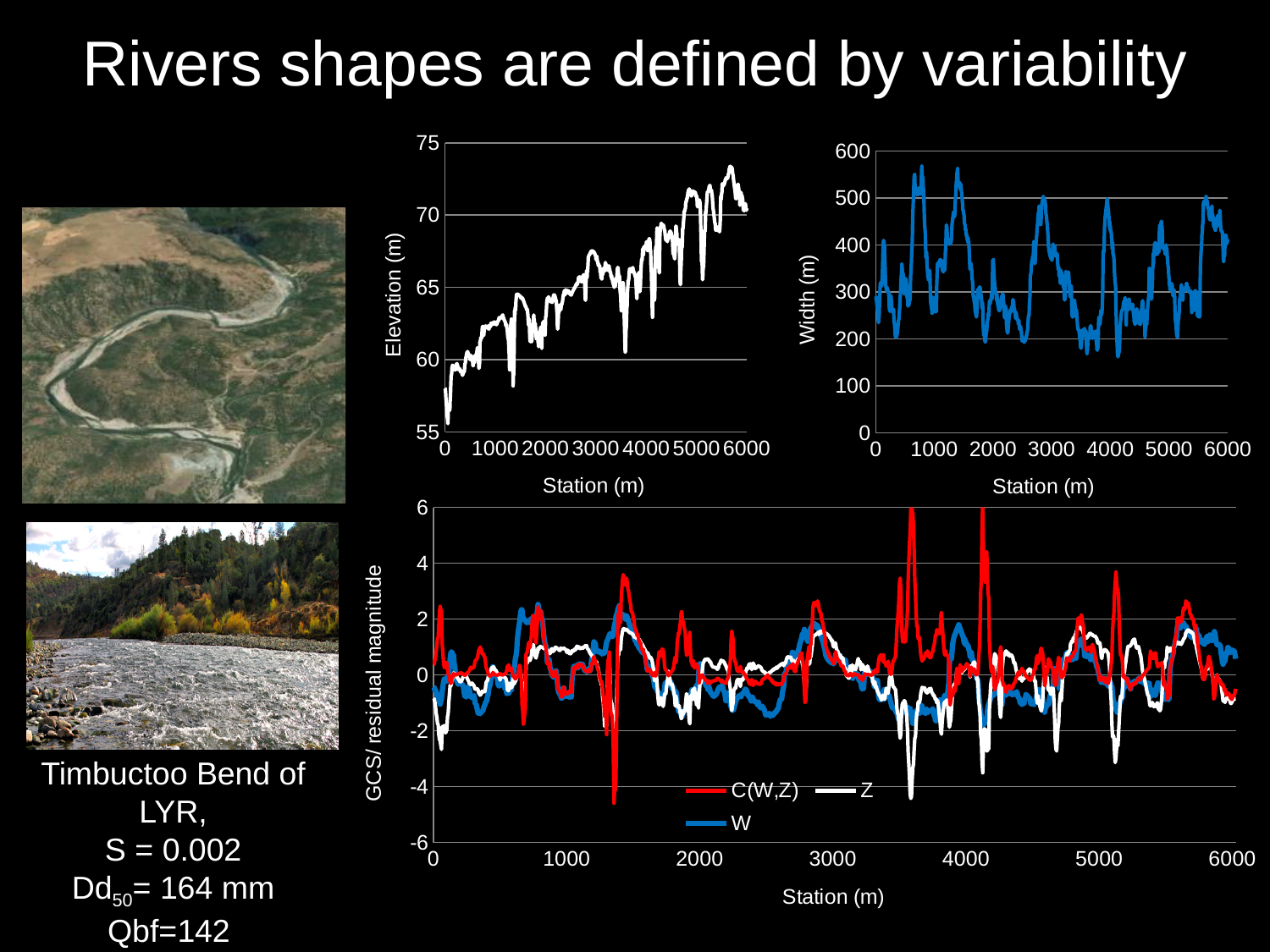
What kind of chart is the Elevation (m) vs Station (m) chart at the top middle of the slide? line chart How many series does the legend of the bottom GCS/residual magnitude chart list? 3 What kind of chart is the Width (m) vs Station (m) chart at the top right? line chart In the Elevation (m) chart, does elevation generally rise or fall as station increases from 0 to 6000 m? rise In the Width (m) chart, is the highest width value greater or less than 500? greater In the Elevation (m) chart, is the elevation at station 0 greater or less than 60? less In the bottom GCS/residual magnitude chart, what colour is the W series? blue In the Width (m) chart, is the lowest width value greater or less than 200? less What are the legend entries in the bottom GCS/residual magnitude chart? C(W,Z), Z, W